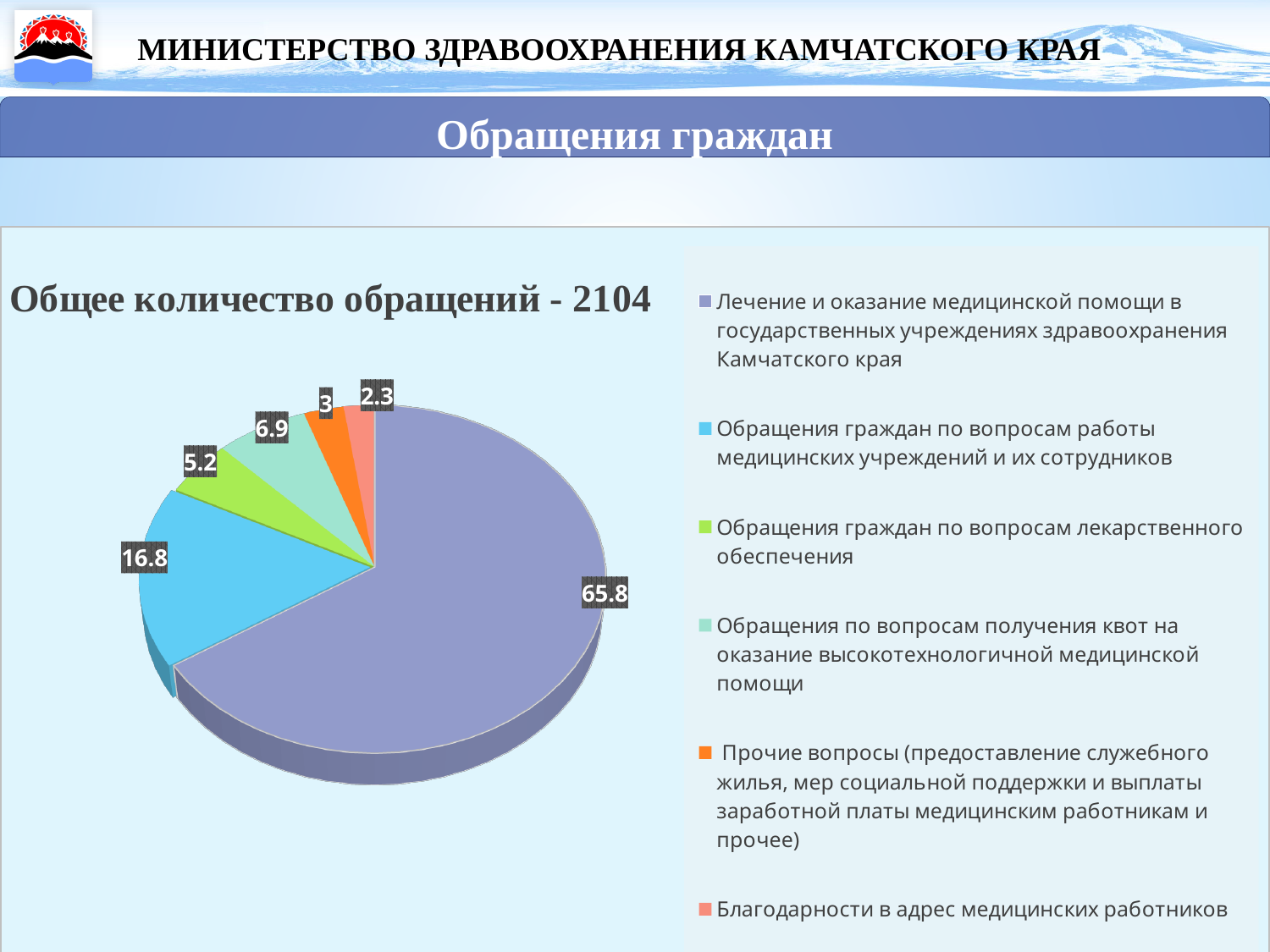
What is the value for "Обращения граждан по вопросам лекарственного обеспечения"? 5.2 Which category has the largest slice of the pie? Лечение и оказание медицинской помощи в государственных учреждениях здравоохранения Камчатского края What is the difference between the value for "Лечение и оказание медицинской помощи в государственных учреждениях здравоохранения Камчатского края" and the value for "Обращения граждан по вопросам работы медицинских учреждений и их сотрудников"? 49 How many entries does the legend list? 6 Which category has the smallest slice of the pie? Благодарности в адрес медицинских работников What is the title of the chart? Общее количество обращений - 2104 How many slices does the pie chart have? 6 What kind of chart is shown on the slide? Pie chart What is the value for "Благодарности в адрес медицинских работников"? 2.3 What is the value for "Лечение и оказание медицинской помощи в государственных учреждениях здравоохранения Камчатского края"? 65.8 Which is larger: the value for "Обращения по вопросам получения квот на оказание высокотехнологичной медицинской помощи" or the value for "Обращения граждан по вопросам лекарственного обеспечения"? Обращения по вопросам получения квот на оказание высокотехнологичной медицинской помощи What is the value for "Обращения граждан по вопросам работы медицинских учреждений и их сотрудников"? 16.8